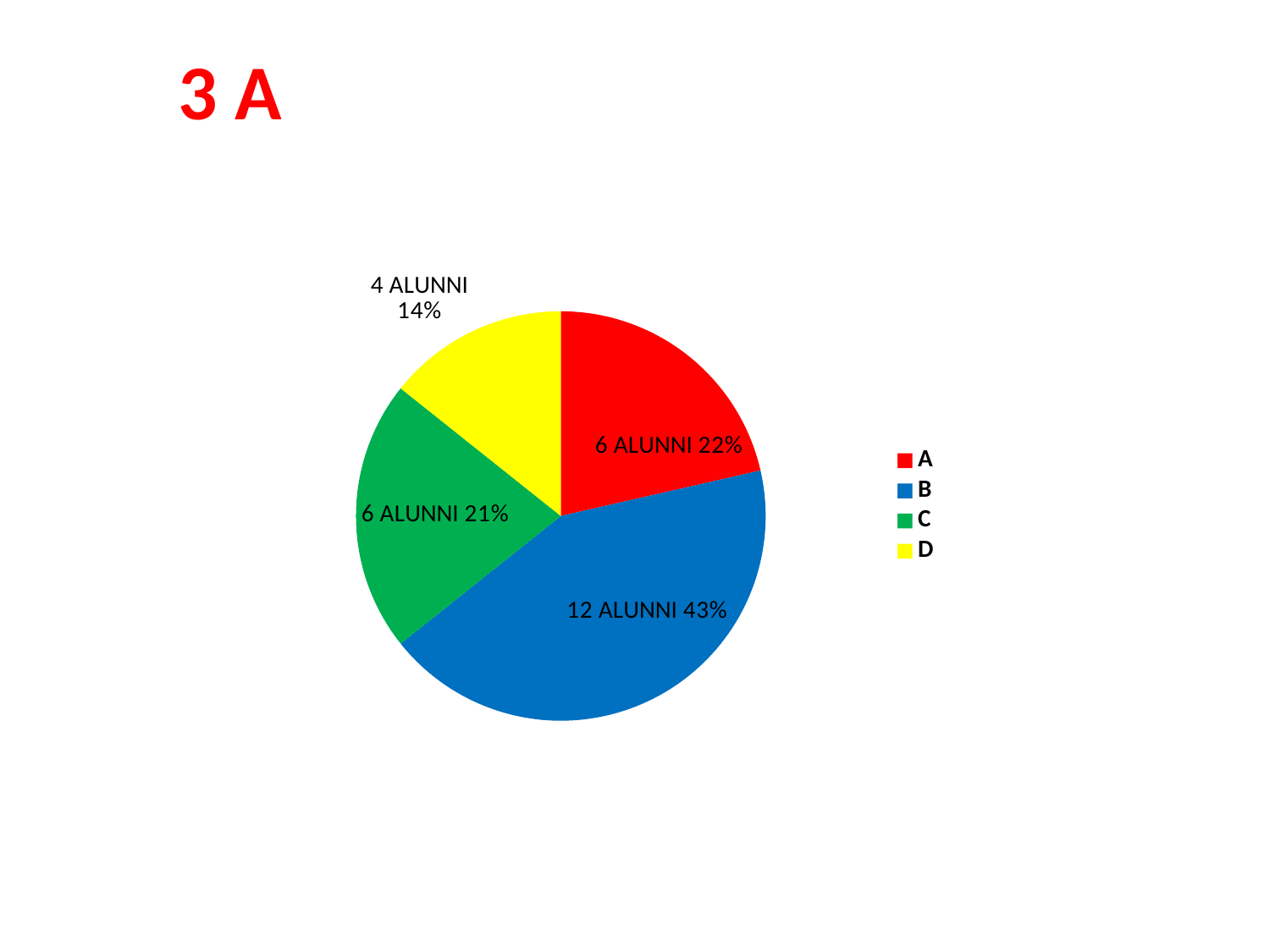
What kind of chart is shown on the slide? pie chart What percentage share does slice D have? 14% How many entries does the legend list? 4 What percentage share does slice A have? 22% How many alunni are in category B? 12 ALUNNI How many alunni are in category D? 4 ALUNNI Which category has the largest slice? B What is the difference in alunni between category B and category D? 8 How many slices does the pie chart have? 4 What percentage share does slice B have? 43% Which is larger, the slice for B or the slice for D? B Which category has the smallest slice? D